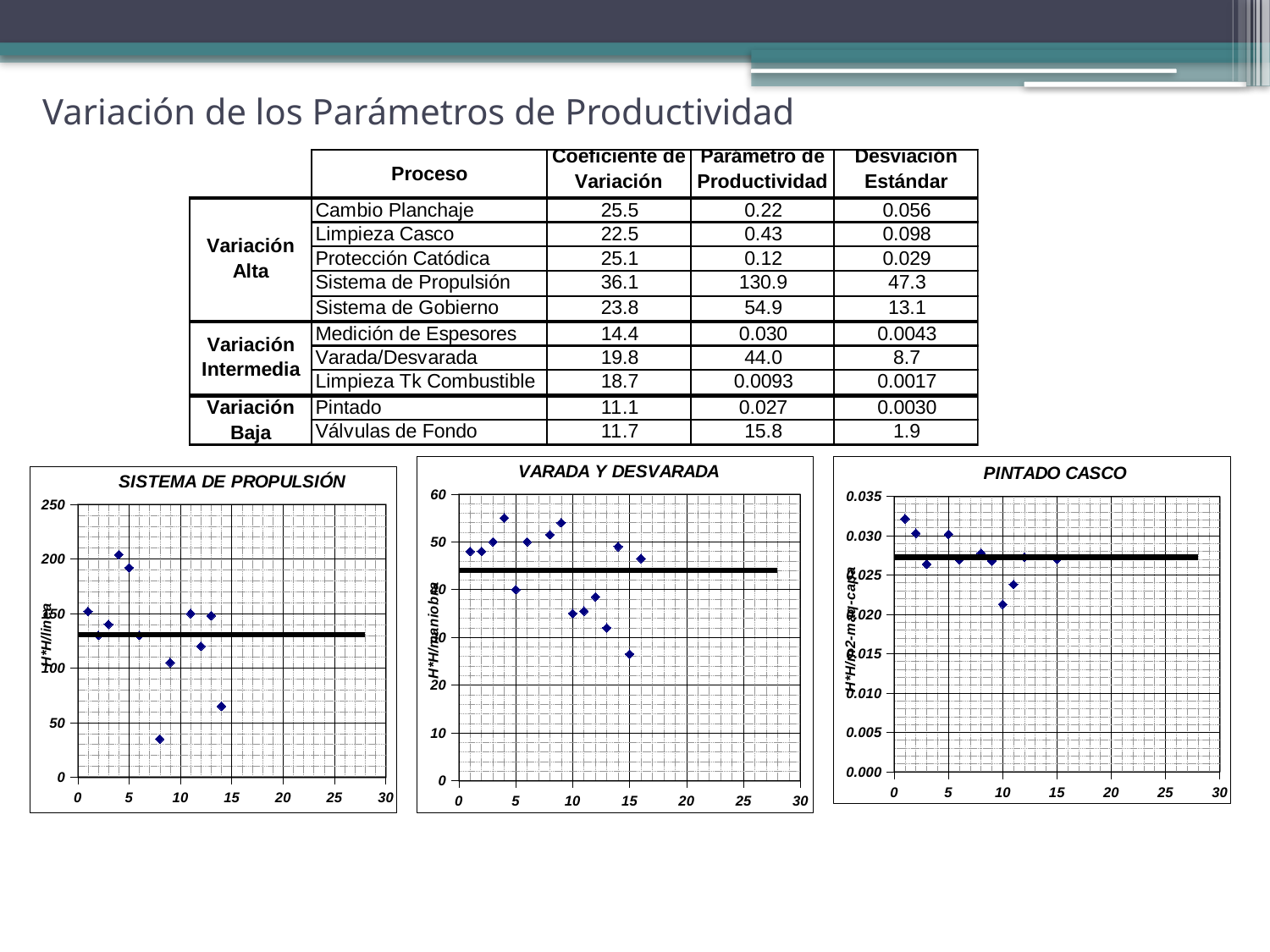
In the PINTADO CASCO chart, is the highest plotted point greater or less than 0.030? greater In the PINTADO CASCO chart, is the lowest plotted point greater or less than 0.025? less In the PINTADO CASCO chart, is the horizontal line greater or less than 0.030? less What is the title of the rightmost chart on the slide? PINTADO CASCO What is the title of the middle chart on the slide? VARADA Y DESVARADA What kind of chart is the SISTEMA DE PROPULSIÓN chart? scatter chart